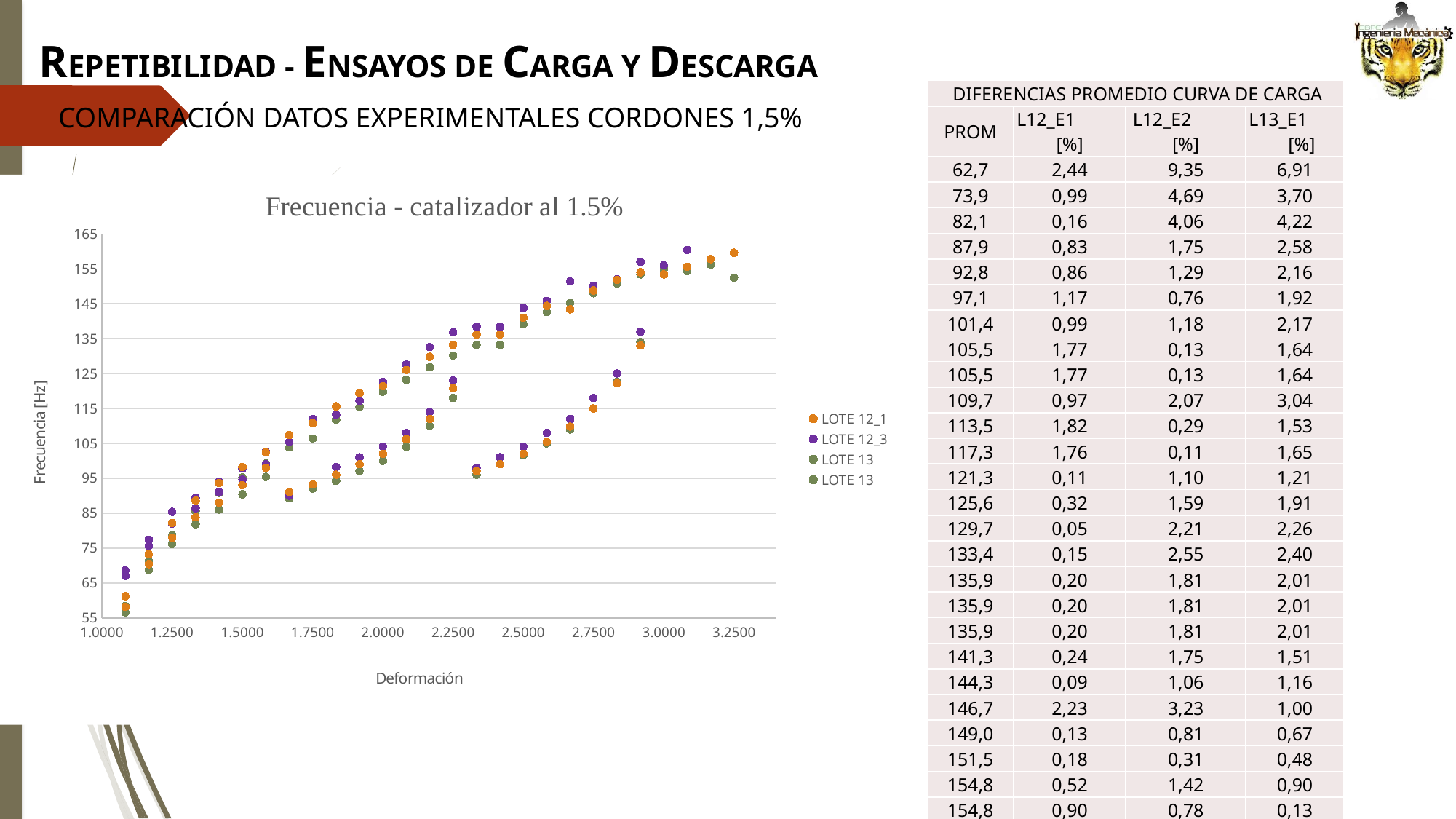
What kind of chart is shown on the slide? Scatter chart What is the label of the vertical axis of the chart? Frecuencia [Hz] Is the lowest frequency value plotted on the chart greater or less than 65? less Is the highest frequency value plotted on the chart greater or less than 165? less How many series does the legend of the chart list? 4 What is the title of the chart? Frecuencia - catalizador al 1.5% Do the plotted frequency values generally rise or fall as Deformación increases along the x axis? Rise Is the highest frequency value plotted on the chart greater or less than 155? greater